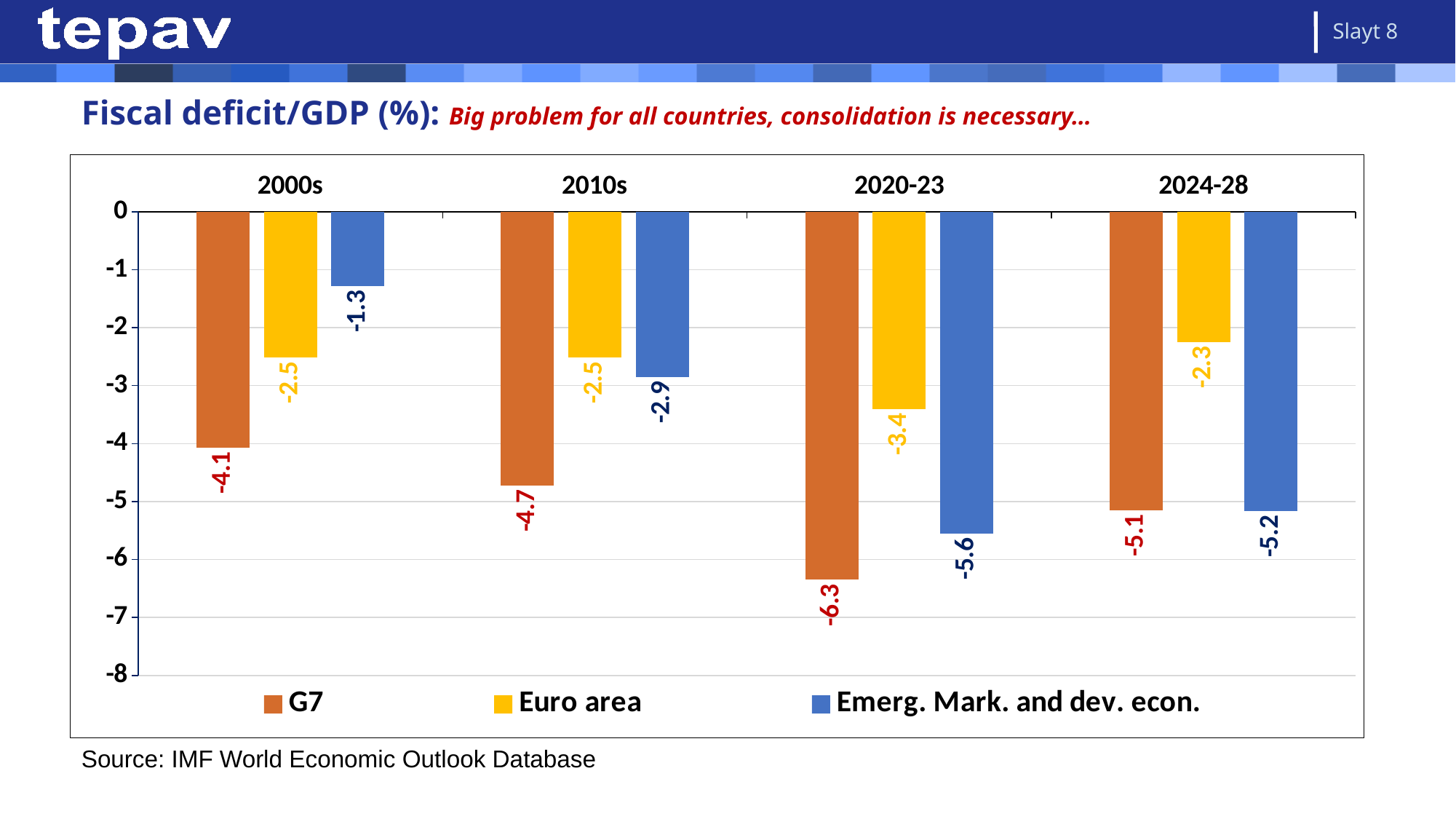
What is the source cited below the chart? IMF World Economic Outlook Database Which period has the highest (least negative) value for Emerg. Mark. and dev. econ.? 2000s How many periods are shown on the x axis? 4 What is the G7 fiscal deficit/GDP value for 2020-23? -6.3 Do the Euro area values rise or fall from 2010s to 2020-23? fall Which period has the lowest (most negative) G7 value? 2020-23 What is the difference between the G7 value and the Euro area value in 2020-23? 2.9 How many series does the legend list? 3 What kind of chart is shown on the slide? bar chart In 2024-28, which is more negative: G7 or Emerg. Mark. and dev. econ.? Emerg. Mark. and dev. econ. What is the Euro area value for 2024-28? -2.3 What is the value for Emerg. Mark. and dev. econ. in the 2000s? -1.3